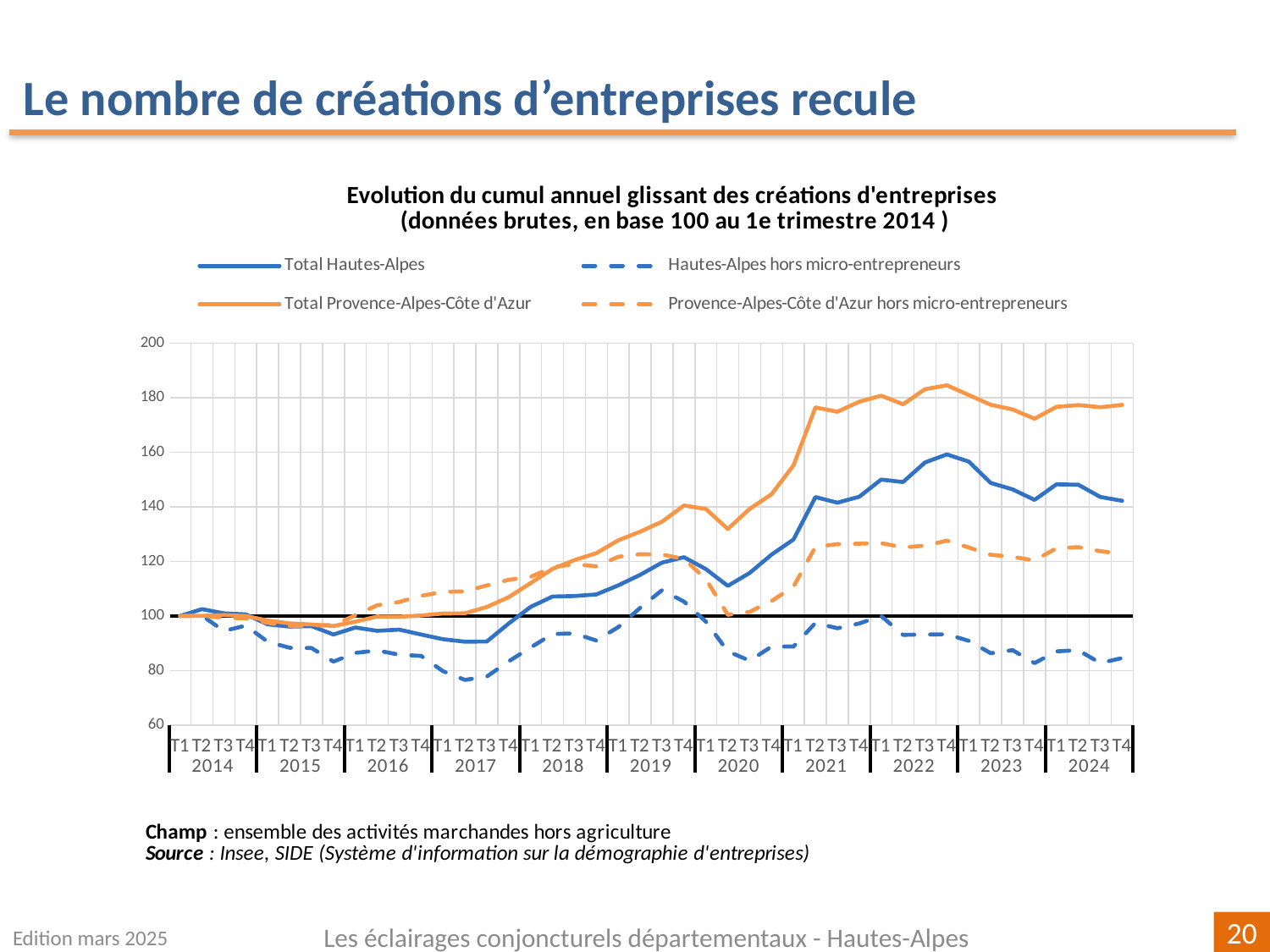
At T4 2022, which is larger: Total Provence-Alpes-Côte d'Azur or Total Hautes-Alpes? Total Provence-Alpes-Côte d'Azur Is the value for Hautes-Alpes hors micro-entrepreneurs at T4 2024 greater or less than 100? less Which colour is used for the Hautes-Alpes series in the chart? blue What type of chart is shown on the slide? line chart Is the value for Total Provence-Alpes-Côte d'Azur at T4 2024 greater or less than 160? greater What is the value of every series at T1 2014, the base period? 100 Which series is the lowest at T4 2024? Hautes-Alpes hors micro-entrepreneurs Overall, does the Total Provence-Alpes-Côte d'Azur series rise or fall between 2014 and 2024? rise Is the value for Total Hautes-Alpes at T4 2024 greater or less than 160? less Which series is the highest at T4 2024? Total Provence-Alpes-Côte d'Azur How many years are labelled along the x axis? 11 How many series does the legend list? 4